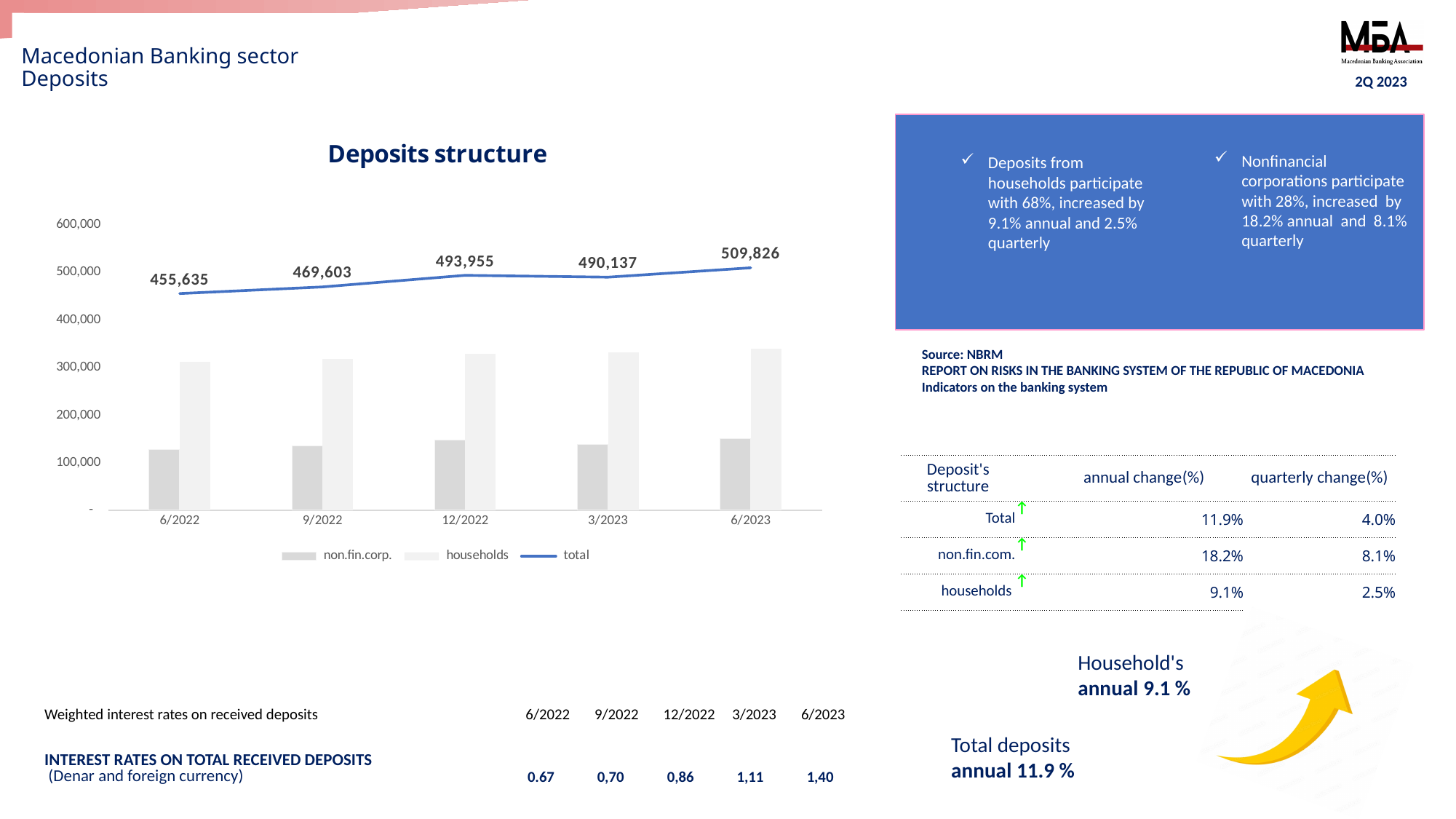
Does the total deposits line in the Deposits structure chart generally rise or fall from 6/2022 to 6/2023? rise In which period is the total deposits value highest in the Deposits structure chart? 6/2023 What is the total deposits value for 6/2022 in the Deposits structure chart? 455,635 What is the total deposits value for 12/2022 in the Deposits structure chart? 493,955 What is the difference between the total deposits for 6/2023 and 6/2022 in the Deposits structure chart? 54,191 In which period is the total deposits value lowest in the Deposits structure chart? 6/2022 Which period has the larger total deposits value, 12/2022 or 3/2023? 12/2022 Is the households value for 6/2023 in the Deposits structure chart greater or less than 300,000? greater How many periods are shown on the x axis of the Deposits structure chart? 5 What is the total deposits value for 6/2023 in the Deposits structure chart? 509,826 Is the non.fin.corp. value for 6/2023 in the Deposits structure chart greater or less than 200,000? less How many series does the legend of the Deposits structure chart list? 3